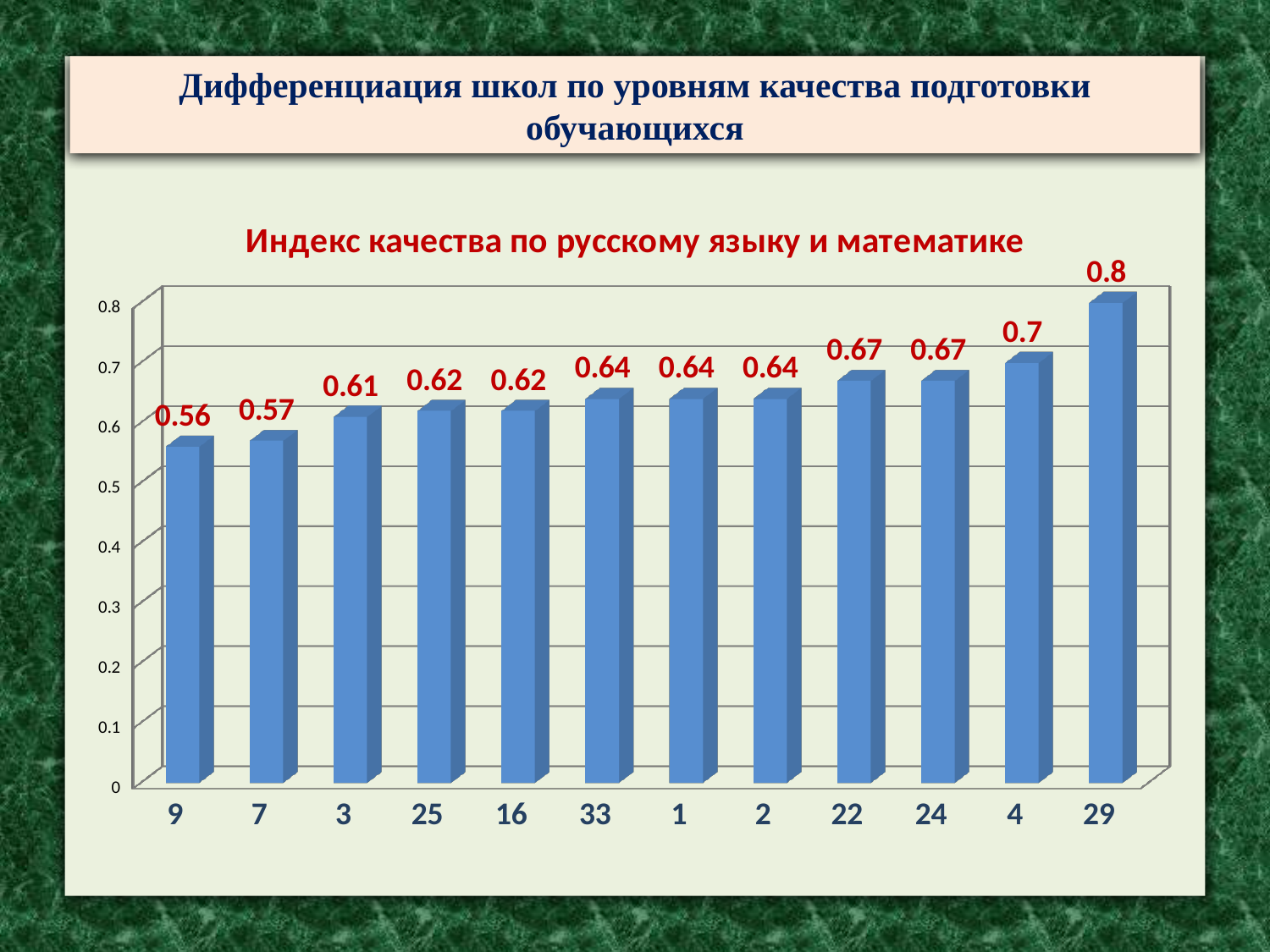
Is the value for school 7 greater or less than 0.6? less Which has a higher quality index, school 3 or school 4? 4 What is the difference between the quality index of school 29 and school 9? 0.24 What is the quality index value for school 9? 0.56 What is the title of the chart? Индекс качества по русскому языку и математике What kind of chart is shown on the slide? bar chart Do the values rise or fall from left to right along the x axis? rise How many schools are shown on the chart? 12 Which school has the highest quality index? 29 What is the quality index value for school 29? 0.8 Which school has the lowest quality index? 9 What is the quality index value for school 33? 0.64